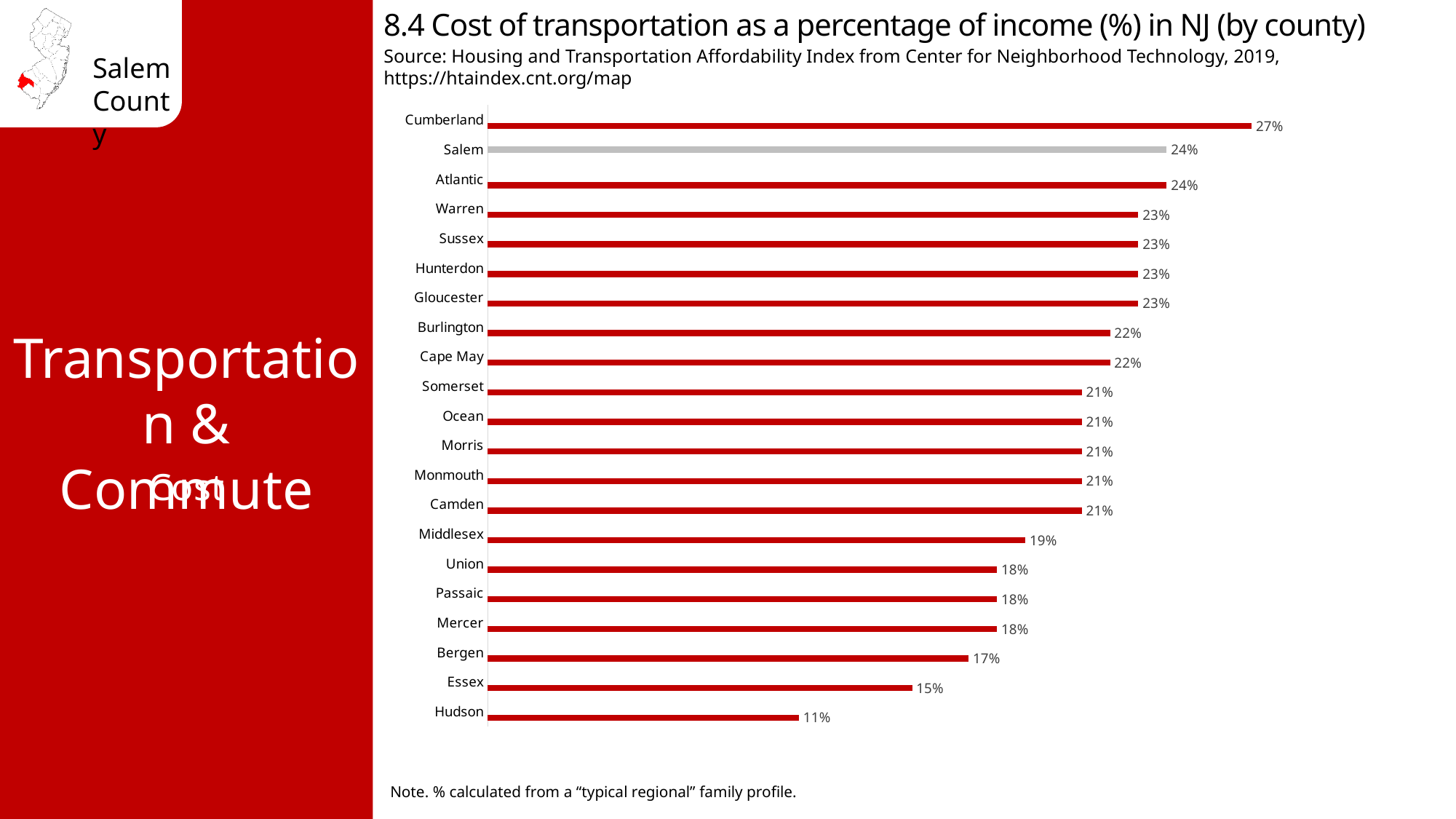
What is the cost of transportation as a percentage of income for Salem county? 24% How many counties are shown in the chart? 21 What is the difference between the values for Cumberland and Hudson? 16% Which county has a larger value, Bergen or Essex? Bergen What is the value shown for Middlesex county? 19% What type of chart is shown on the slide? Bar chart Which county's bar is shown in grey rather than red? Salem What is the difference between the values for Salem and Essex? 9% What is the cost of transportation as a percentage of income for Hudson county? 11% Which county has the highest cost of transportation as a percentage of income? Cumberland Which county has a larger value, Cumberland or Atlantic? Cumberland Which county has the lowest cost of transportation as a percentage of income? Hudson